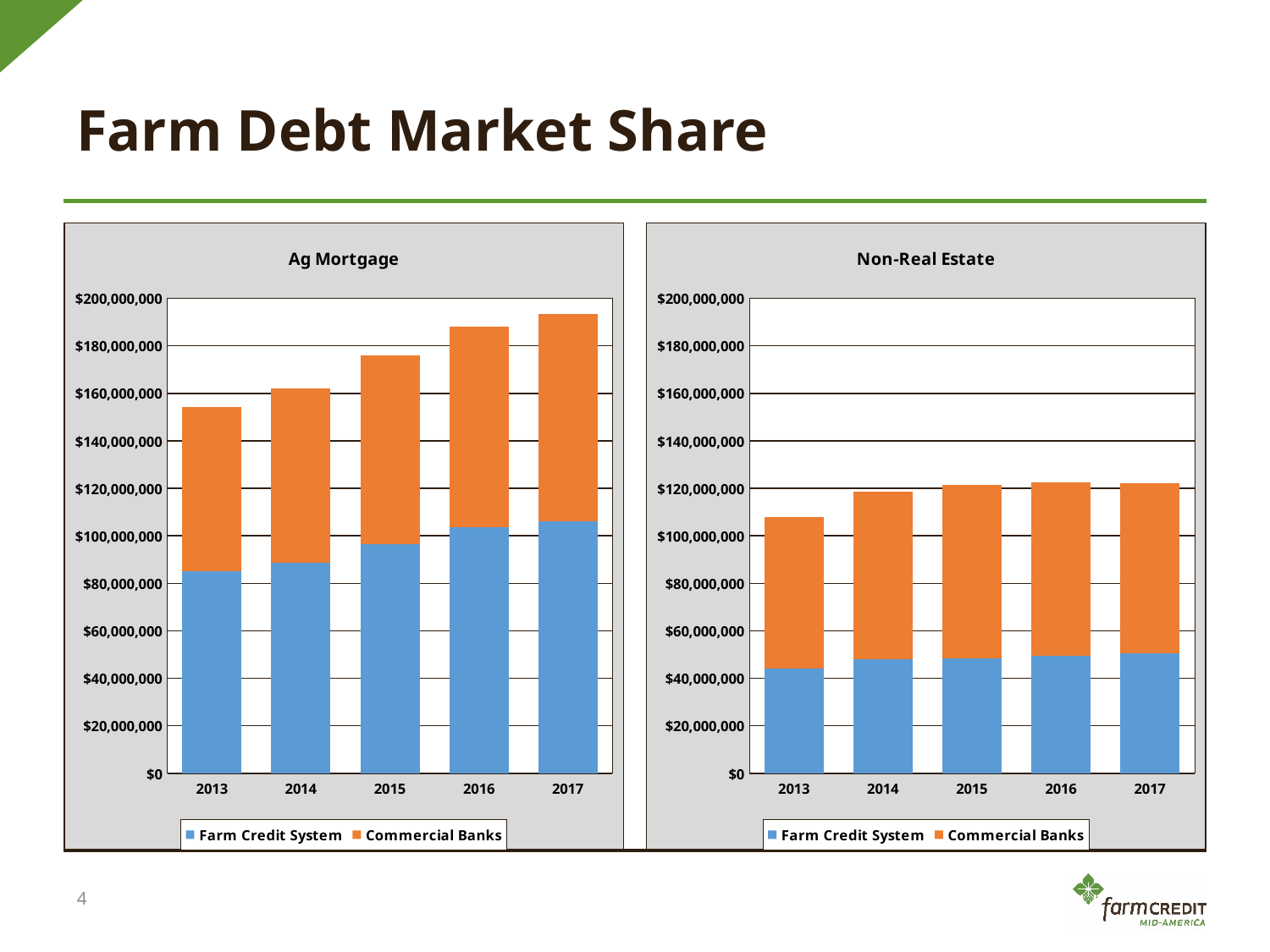
In the Ag Mortgage chart, is the Farm Credit System value for 2017 greater or less than $100,000,000? greater In the Ag Mortgage chart, which year has the highest total bar? 2017 How many series does the legend of the Non-Real Estate chart list? 2 In the Ag Mortgage chart, which colour represents Commercial Banks? Orange In the Non-Real Estate chart, is the total for 2013 greater or less than $100,000,000? greater In the Ag Mortgage chart, do the total bar heights rise or fall from 2013 to 2017? Rise What kind of chart is the Ag Mortgage chart? Stacked bar chart In the Non-Real Estate chart, is the Farm Credit System value for 2013 greater or less than $40,000,000? greater How many years are shown on the x axis of the Ag Mortgage chart? 5 In the Non-Real Estate chart, which year has the lowest total bar? 2013